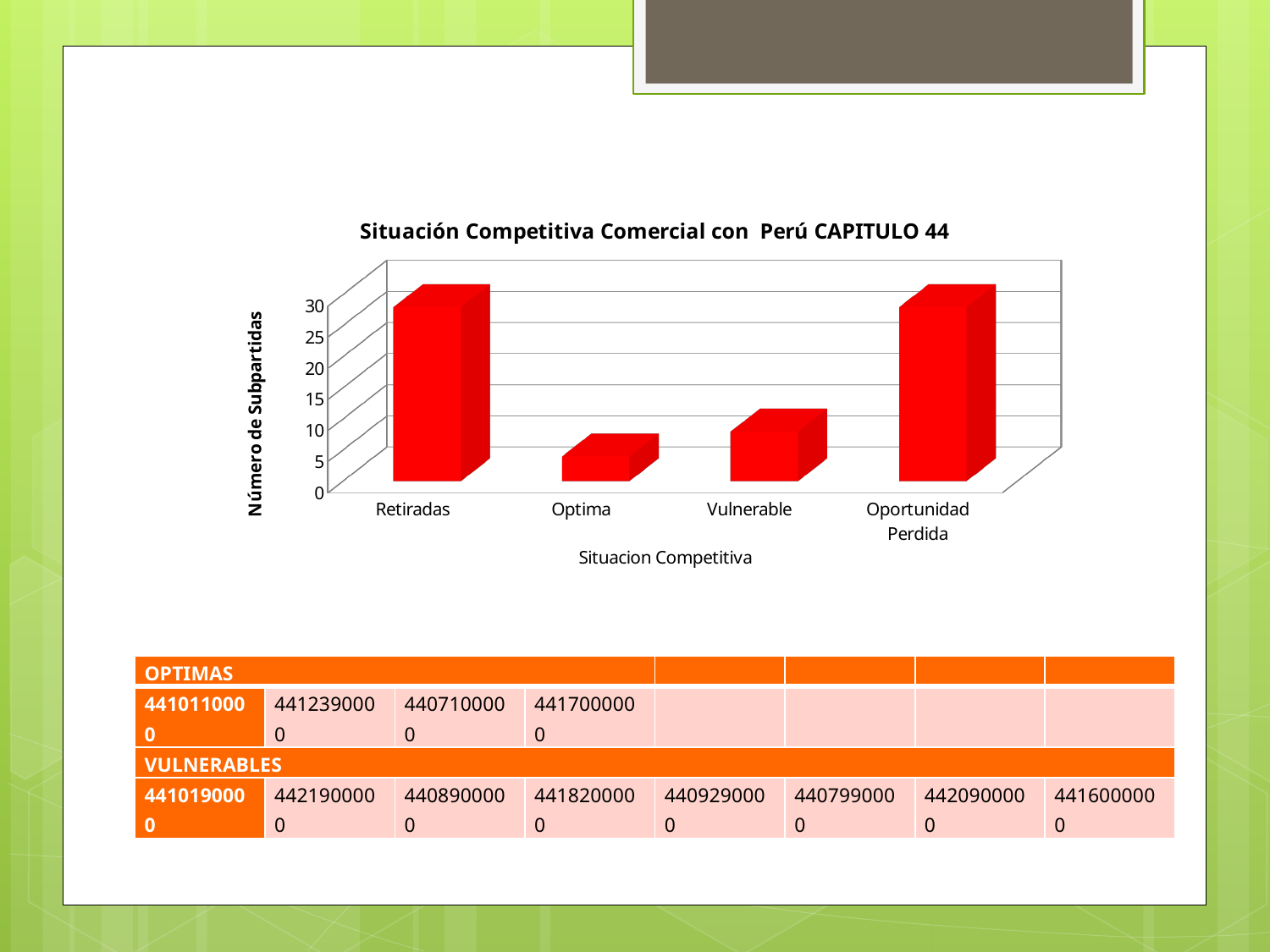
Which category has the lowest value in the chart? Optima Which is larger, the value for Retiradas or the value for Vulnerable? Retiradas What kind of chart is shown on the slide? bar chart Is the value for Vulnerable greater or less than 15? less How many categories are shown on the x axis of the chart? 4 Is the value for Retiradas greater or less than 25? greater What is the title of the chart? Situación Competitiva Comercial con Perú CAPITULO 44 Is the value for Optima greater or less than 10? less What is the label of the vertical axis of the chart? Número de Subpartidas Which is larger, the value for Vulnerable or the value for Optima? Vulnerable